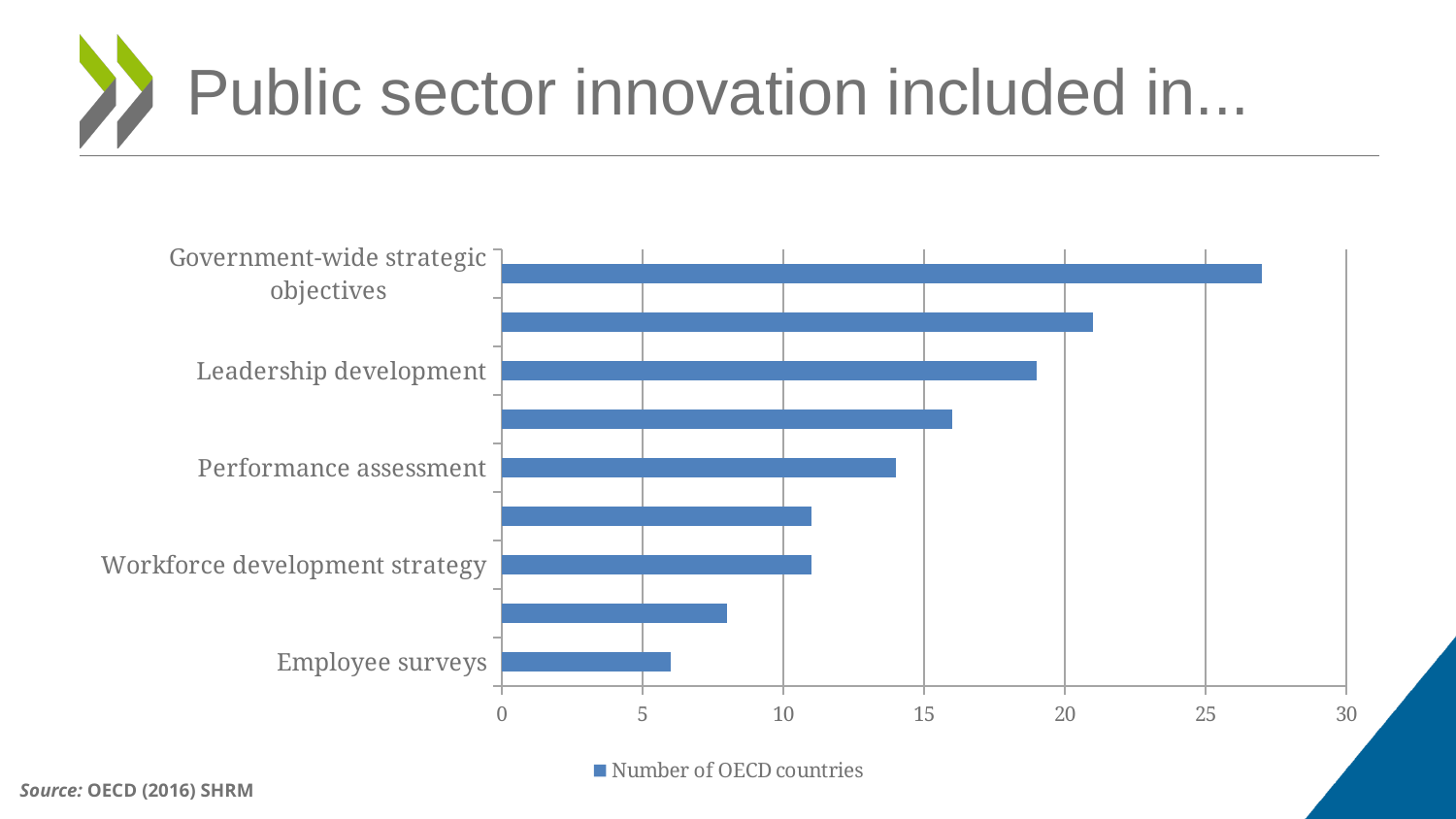
Which category has the highest number of OECD countries? Government-wide strategic objectives Which is larger, the value for Leadership development or the value for Performance assessment? Leadership development Is the value for Performance assessment greater or less than 10? greater How many series does the legend list? 1 What is the name of the series shown in the legend? Number of OECD countries What kind of chart is shown on the slide? Bar chart Is the value for Workforce development strategy greater or less than 15? less Is the value for Employee surveys greater or less than 10? less How many bars are plotted in the chart? 9 Which category has the lowest number of OECD countries? Employee surveys